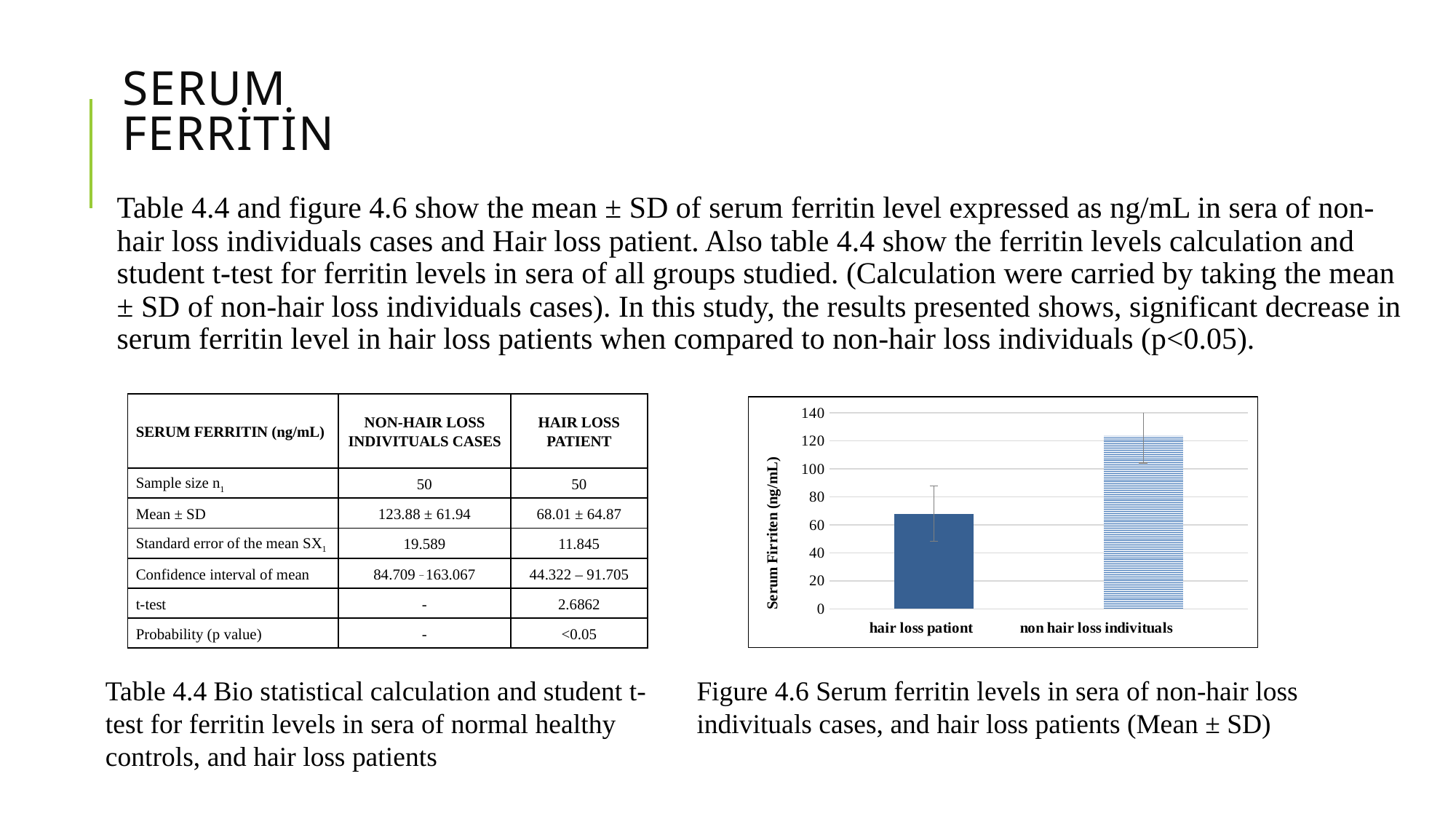
Which category has the highest bar in the chart? non hair loss indivituals Is the bar for hair loss pationt greater or less than 80? less What is the label on the y axis of the chart? Serum Firriten (ng/mL) Is the bar for hair loss pationt greater or less than 60? greater What kind of chart is shown in Figure 4.6? bar chart How many categories are plotted on the x axis of the chart? 2 What is the maximum value shown on the y axis of the chart? 140 Is the bar for non hair loss indivituals greater or less than 140? less Which category has the lowest bar in the chart? hair loss pationt Which bar is taller, hair loss pationt or non hair loss indivituals? non hair loss indivituals